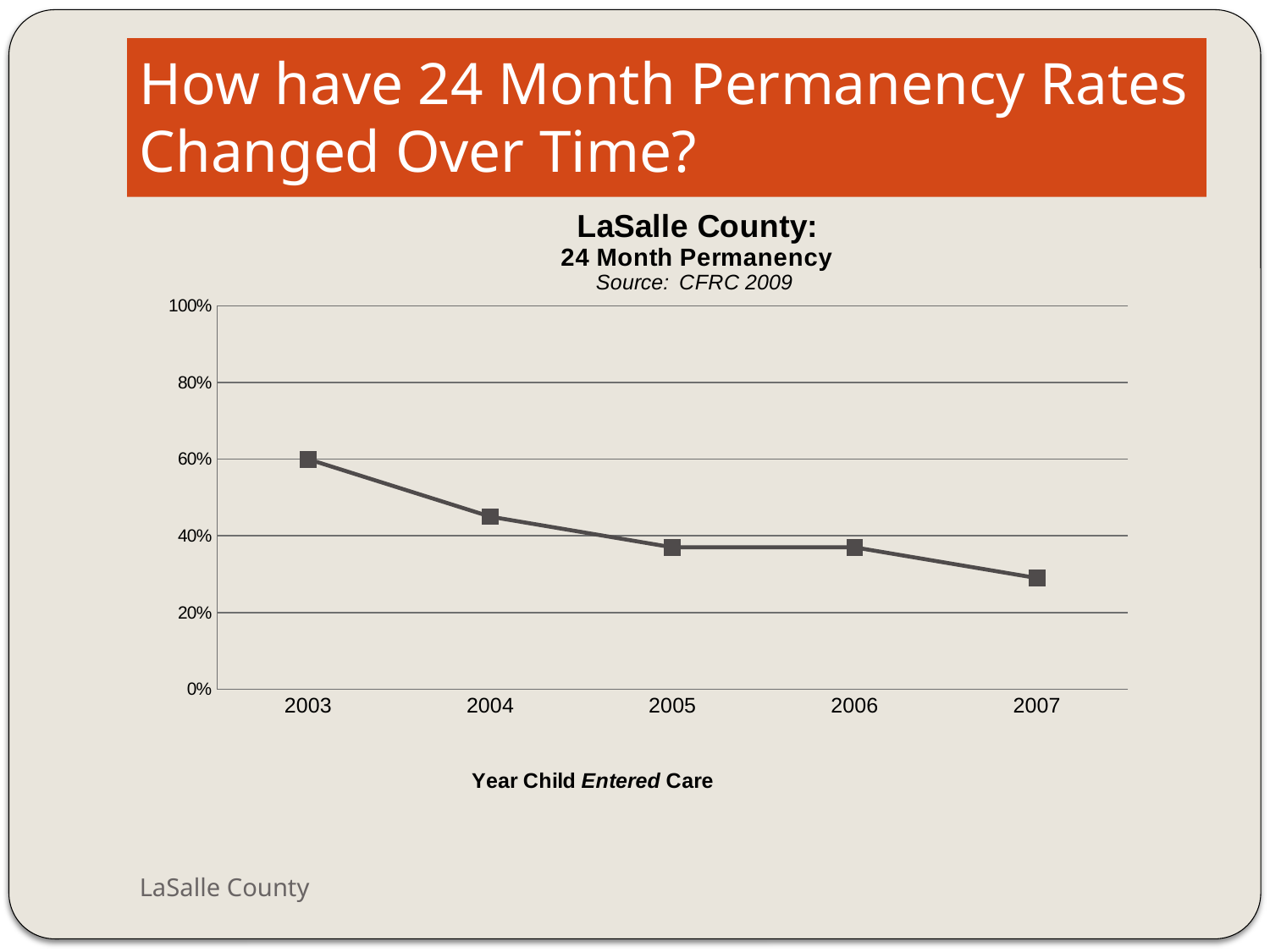
Is the value for 2004 greater or less than 40%? greater Which year has the lowest 24 month permanency rate? 2007 Which year has the larger permanency rate, 2003 or 2007? 2003 Is the value for 2007 greater or less than 20%? greater What source is cited in the chart title? CFRC 2009 Is the value for 2005 greater or less than 40%? less What kind of chart is shown on the slide? line chart Do the permanency rates rise or fall from 2003 to 2007? fall What is the 24 month permanency rate for 2003? 60% How many years are plotted on the x axis? 5 Which year has the highest 24 month permanency rate? 2003 What is the label of the x axis? Year Child Entered Care